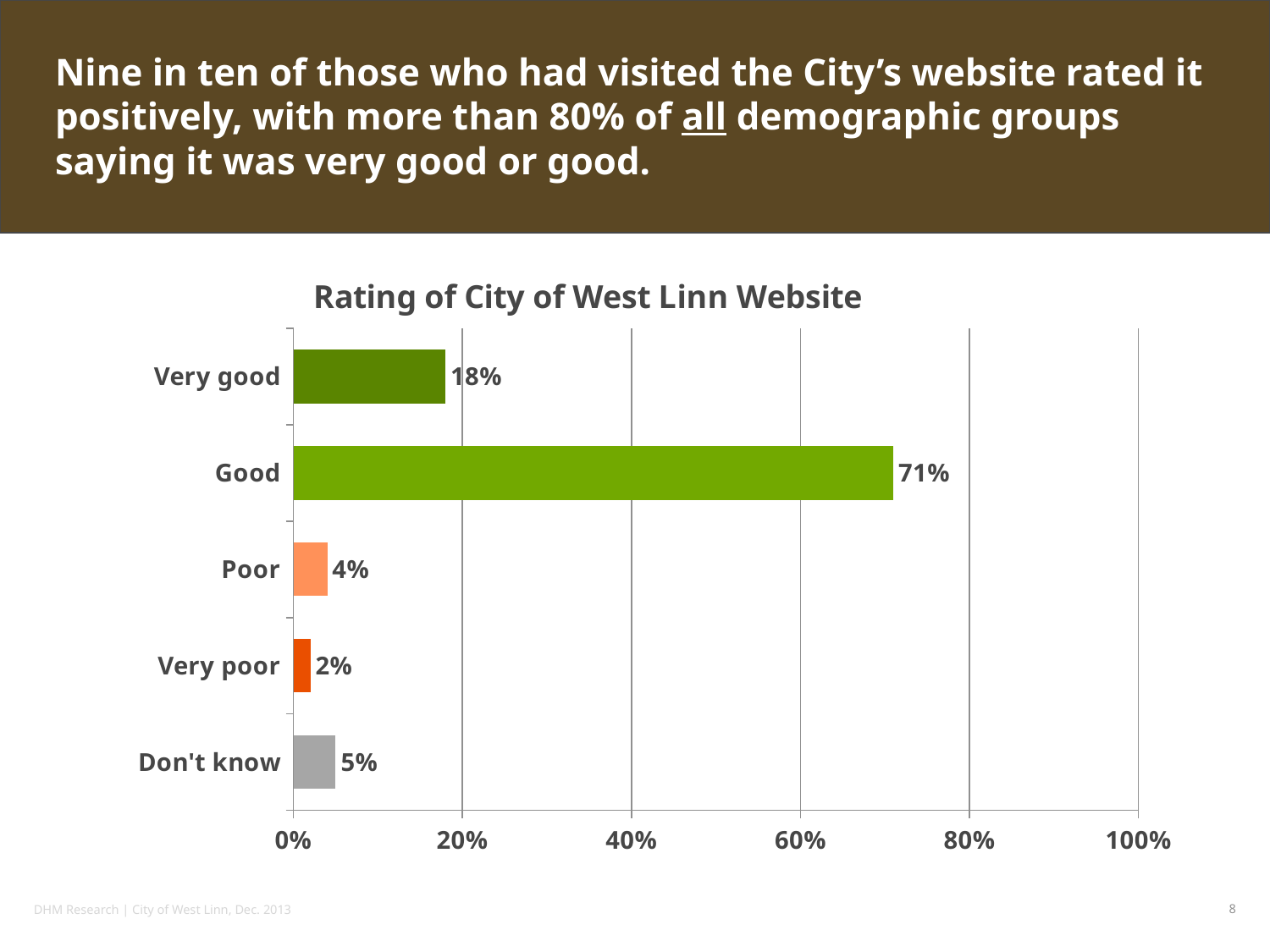
What kind of chart is shown on the slide? Bar chart What percentage rated the City of West Linn website as Good? 71% Which rating category has the highest value? Good What percentage answered Don't know? 5% How many rating categories are shown in the chart? 5 What is the title of the chart? Rating of City of West Linn Website Is the value for Good greater or less than 60%? greater Which rating category has the lowest value? Very poor Which is larger, the value for Poor or the value for Don't know? Don't know What is the difference between the Good and Very good percentages? 53% What percentage rated the website as Very good? 18% What is the combined percentage of Poor and Very poor ratings? 6%